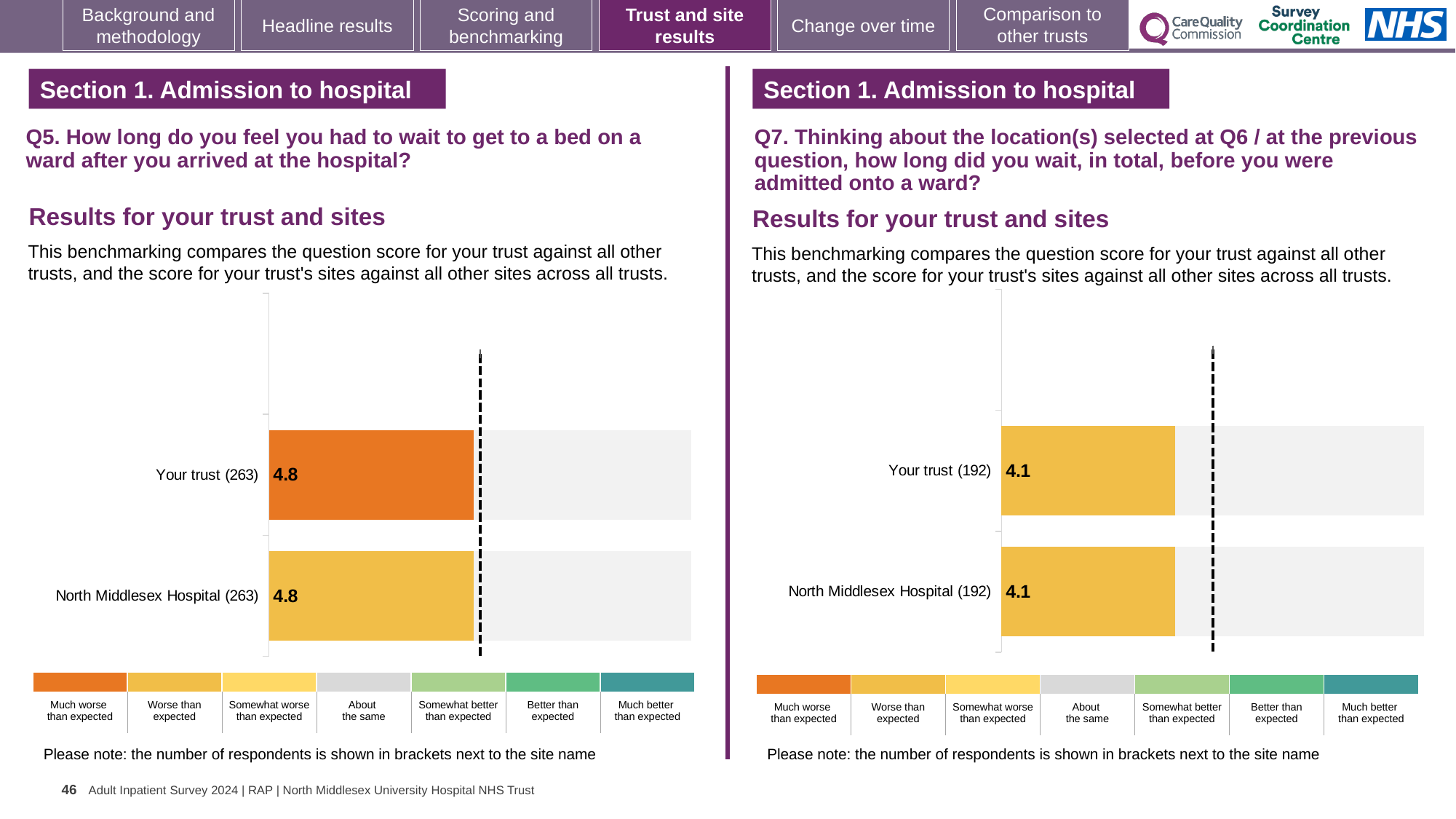
In the right chart (Q7), what is the score for North Middlesex Hospital (192)? 4.1 How many bars are plotted in the right chart (Q7)? 2 In the left chart (Q5), how many respondents are shown in brackets for Your trust? 263 In the right chart (Q7), what is the difference between the score for Your trust and the score for North Middlesex Hospital? 0.0 How many bars are plotted in the left chart (Q5)? 2 In the left chart (Q5), what is the difference between the score for Your trust and the score for North Middlesex Hospital? 0.0 In the left chart (Q5), what is the score for North Middlesex Hospital (263)? 4.8 In the right chart (Q7), which benchmark category does the colour of the North Middlesex Hospital bar correspond to? Worse than expected What kind of chart is used for the Q5 results on the left? Bar chart In the right chart (Q7), what is the score for Your trust (192)? 4.1 In the left chart (Q5), what is the score for Your trust (263)? 4.8 In the left chart (Q5), which benchmark category does the colour of the Your trust bar correspond to? Much worse than expected